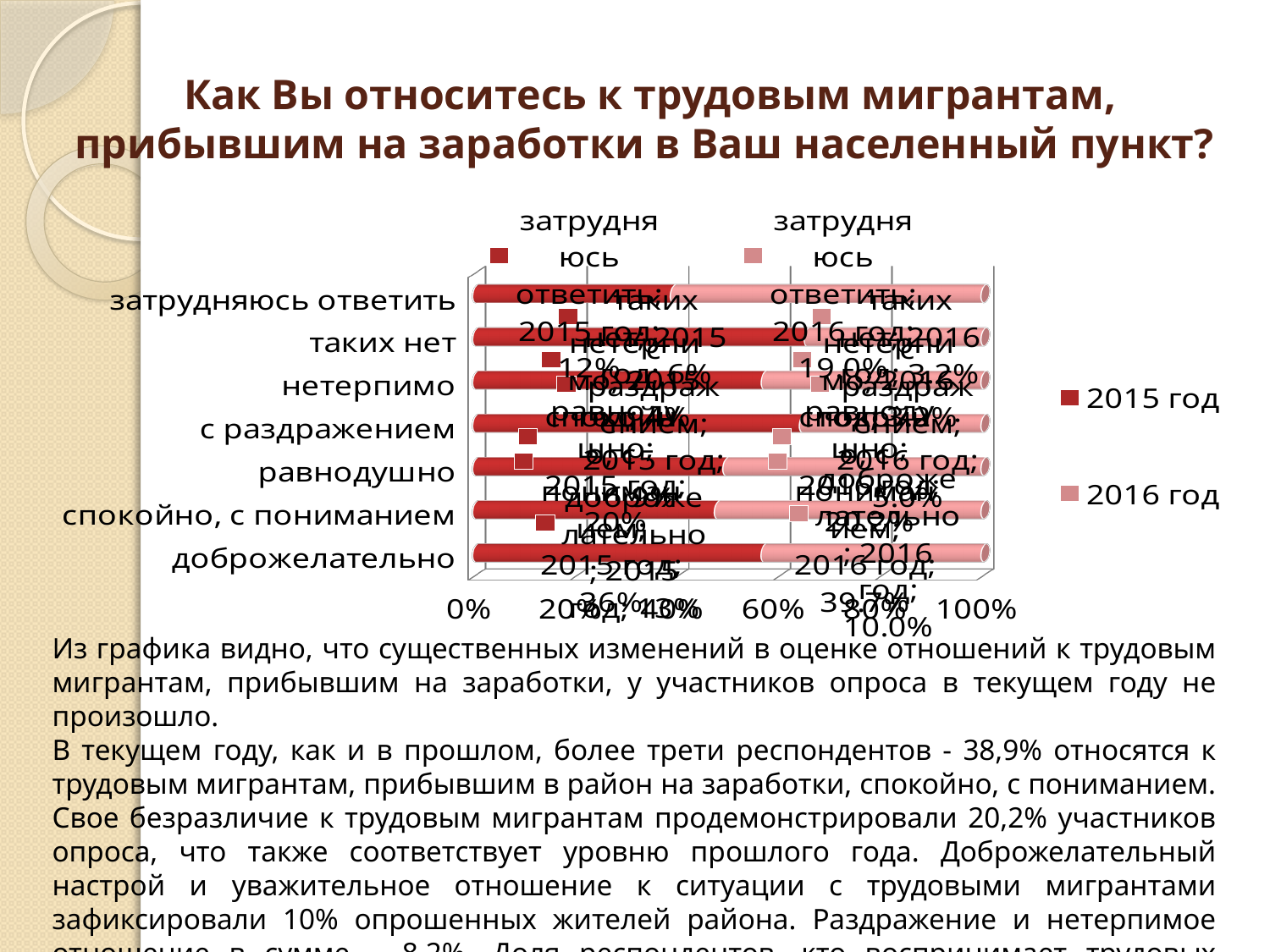
Which category appears at the bottom of the chart's vertical axis? доброжелательно In the bar for 'доброжелательно', which series occupies the larger portion, 2015 год or 2016 год? 2015 год What is the highest value shown on the horizontal axis of the chart? 100% How many categories are shown on the vertical axis of the chart? 7 Which two series are listed in the chart legend? 2015 год and 2016 год What kind of chart is shown on the slide? bar chart Does the 2015 год segment of the 'доброжелательно' bar extend beyond the 40% mark on the horizontal axis, greater or less? greater How many series does the chart legend list? 2